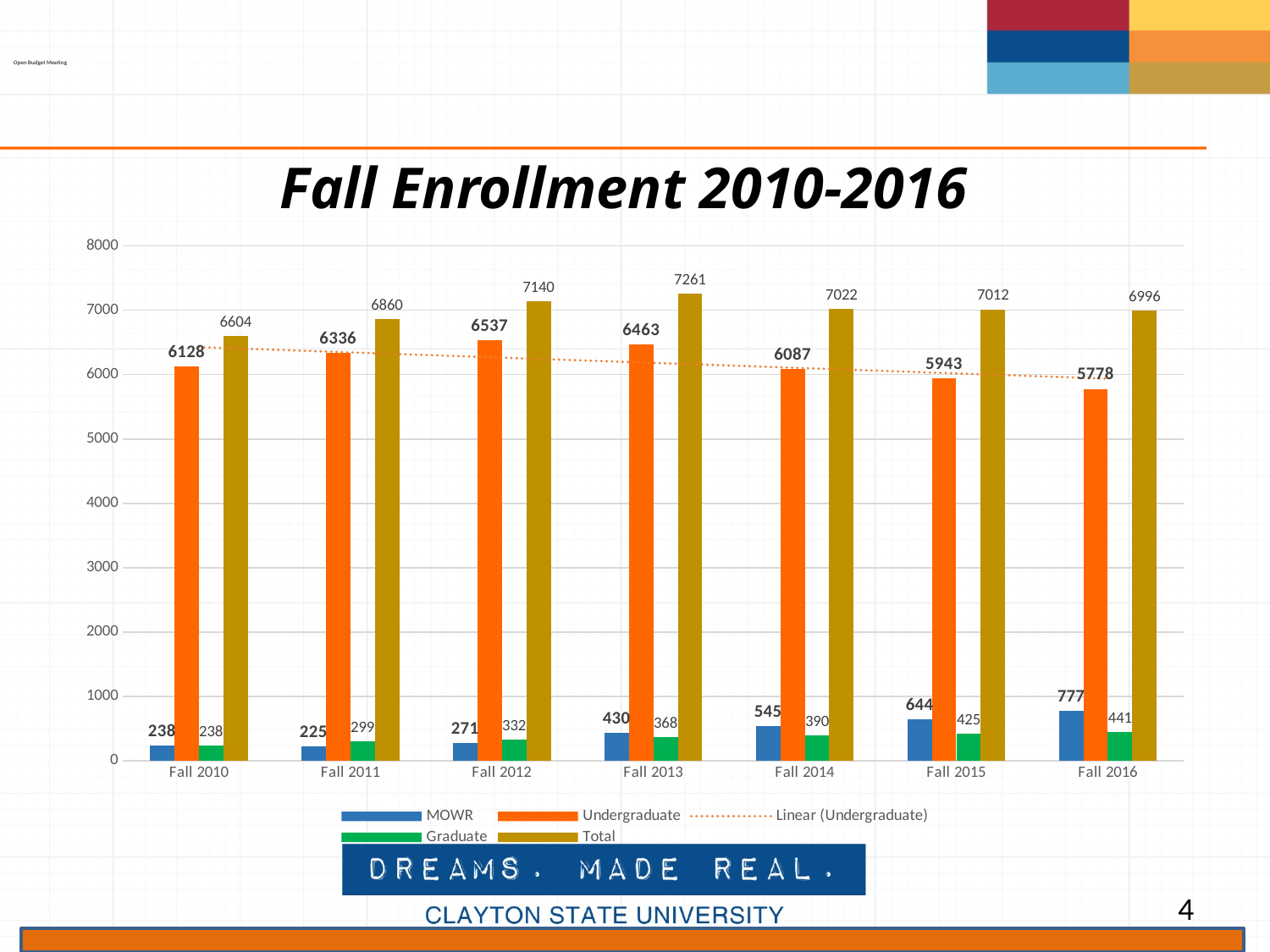
What is the Total enrollment for Fall 2016? 6996 What kind of chart is shown on the slide? Bar chart Which is larger in Fall 2015: the MOWR value or the Graduate value? MOWR What is the Undergraduate enrollment for Fall 2013? 6463 What is the MOWR value for Fall 2014? 545 What is the Graduate value for Fall 2011? 299 How many entries does the legend list? 5 In which fall term is the Undergraduate enrollment lowest? Fall 2016 In which fall term is the Total enrollment highest? Fall 2013 Does the MOWR value rise or fall from Fall 2012 to Fall 2016? Rise What is the difference between the Total enrollment in Fall 2012 and Fall 2010? 536 How many fall terms are shown on the x axis? 7